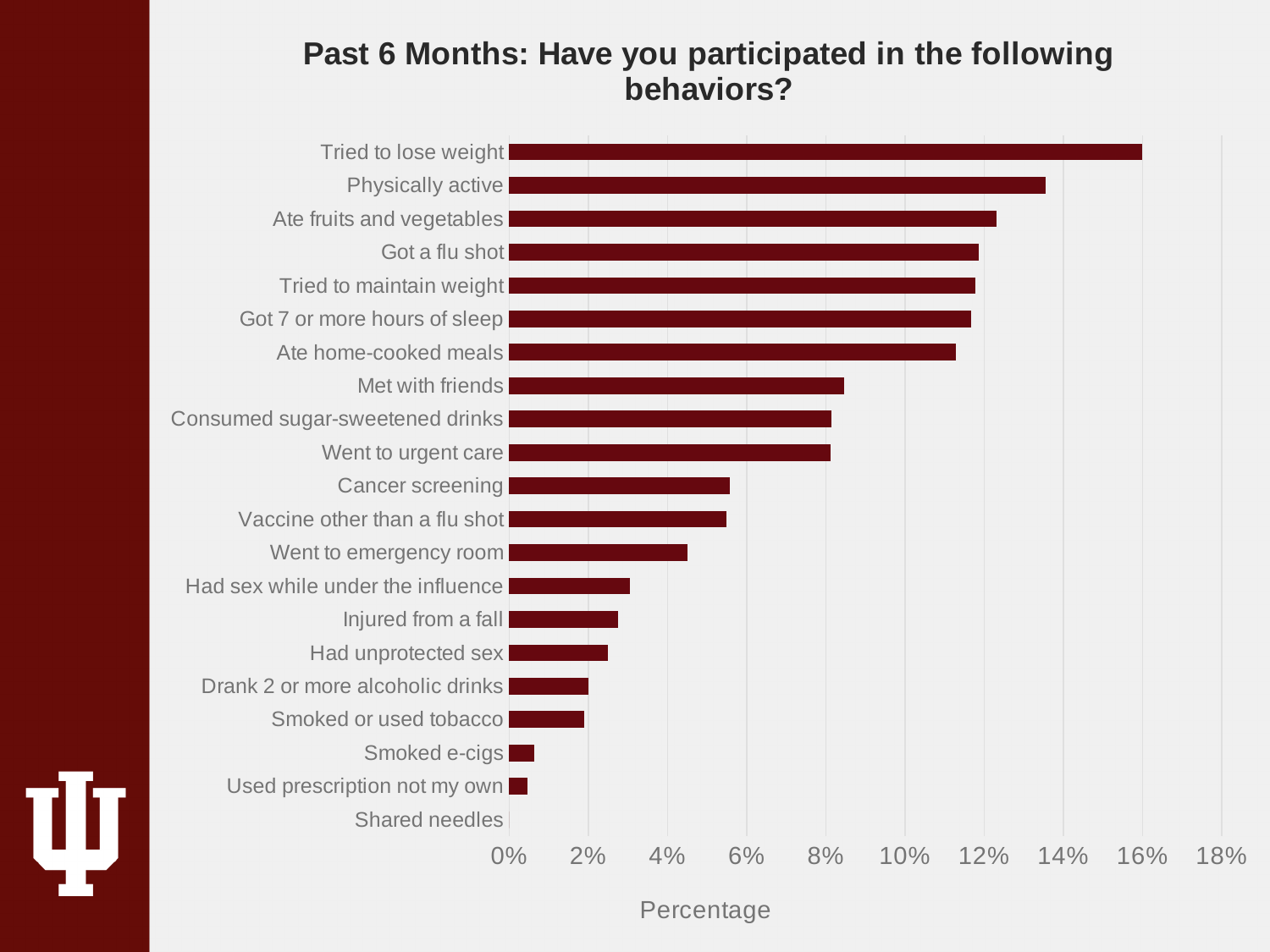
Which is larger, the value for Tried to lose weight or the value for Physically active? Tried to lose weight What kind of chart is shown on the slide? bar chart Which behavior has the highest percentage? Tried to lose weight Is the value for Ate home-cooked meals greater or less than 10%? greater Is the value for Cancer screening greater or less than 6%? less Is the value for Went to emergency room greater or less than 4%? greater Which behavior has the lowest percentage? Shared needles What is the label on the horizontal axis of the chart? Percentage How many behaviors are listed on the chart? 21